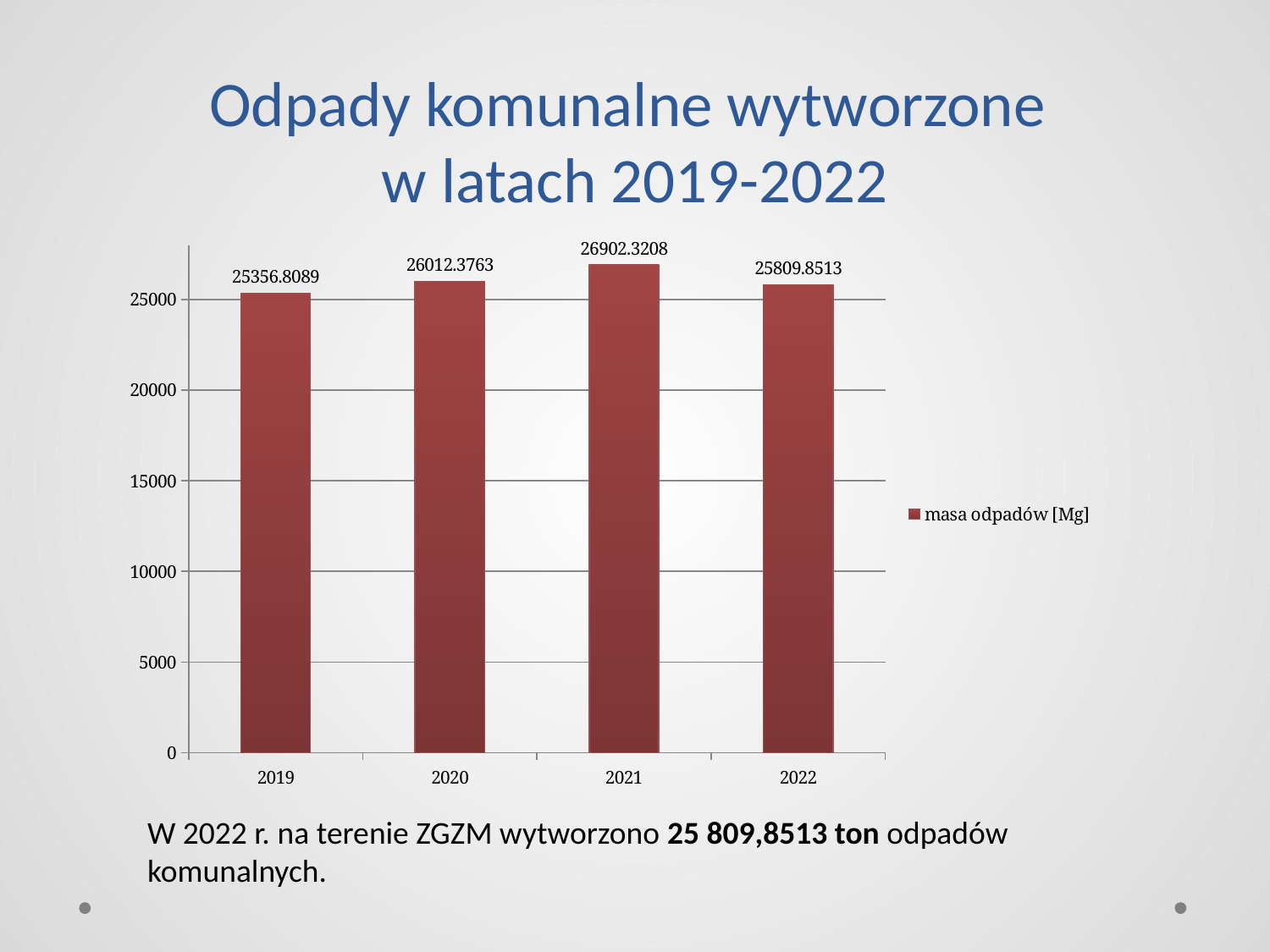
What kind of chart is shown on the slide? bar chart What is the value for 2022? 25809.8513 What is the difference between the values for 2021 and 2022? 1092.4695 Which year has the lowest value? 2019 What is the difference between the values for 2021 and 2019? 1545.5119 What is the value for 2019? 25356.8089 How many years are shown on the x axis? 4 Which year has the highest value? 2021 What is the value for 2021? 26902.3208 What series name does the legend show? masa odpadów [Mg] Which is larger, the value for 2020 or the value for 2022? 2020 Is the value for 2022 greater or less than 20000? greater